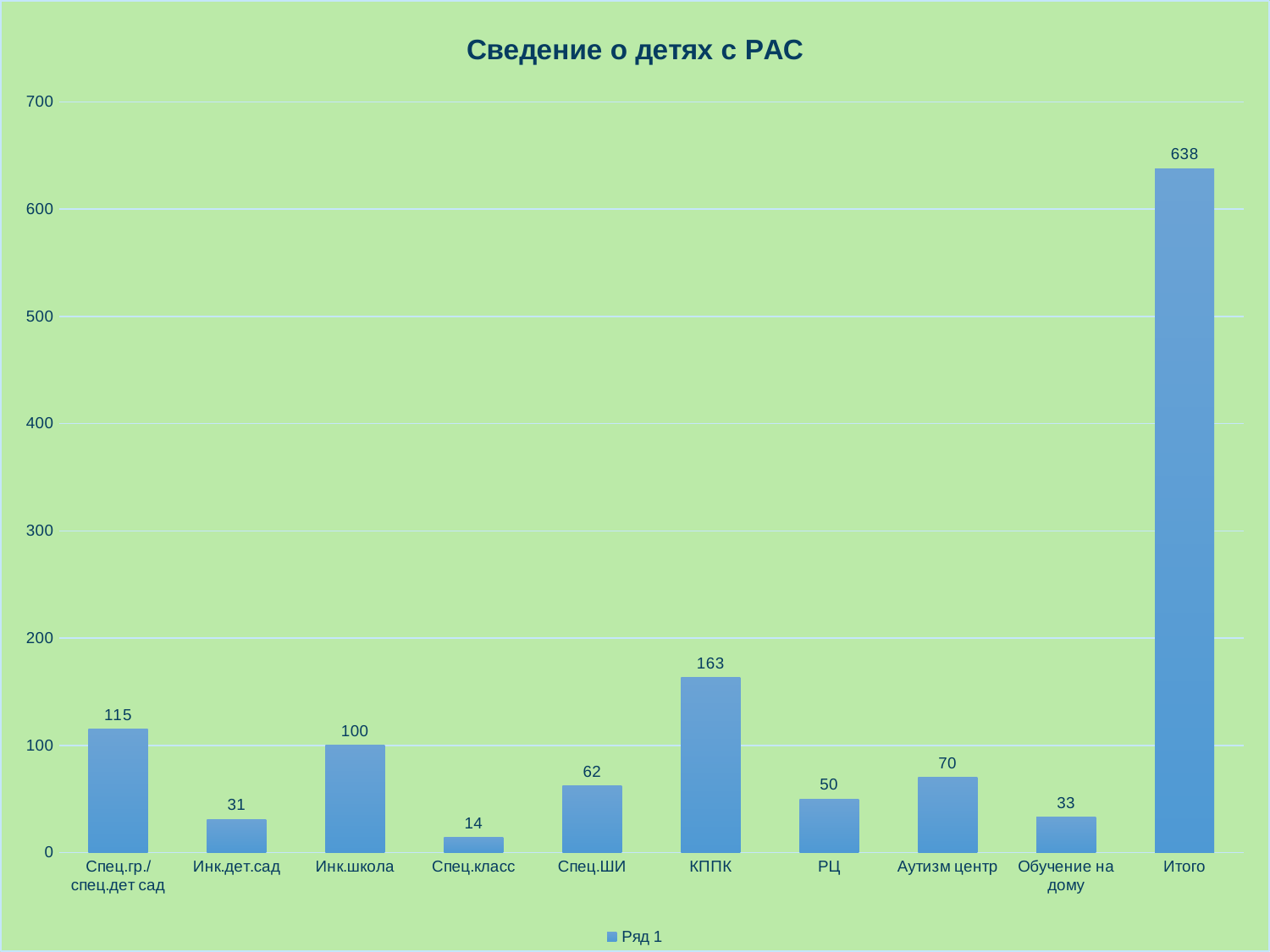
What is the difference between the values for КППК and Инк.школа? 63 How many series does the legend list? 1 What is the value for Итого? 638 Which category has the highest value? Итого Is the value for Спец.гр./спец.дет сад greater or less than 100? greater What is the value for КППК? 163 Which is larger, the value for Аутизм центр or the value for РЦ? Аутизм центр What is the value for Спец.класс? 14 What kind of chart is shown? bar chart Which category has the lowest value? Спец.класс What is the title of the chart? Сведение о детях с РАС How many categories are shown on the x axis? 10